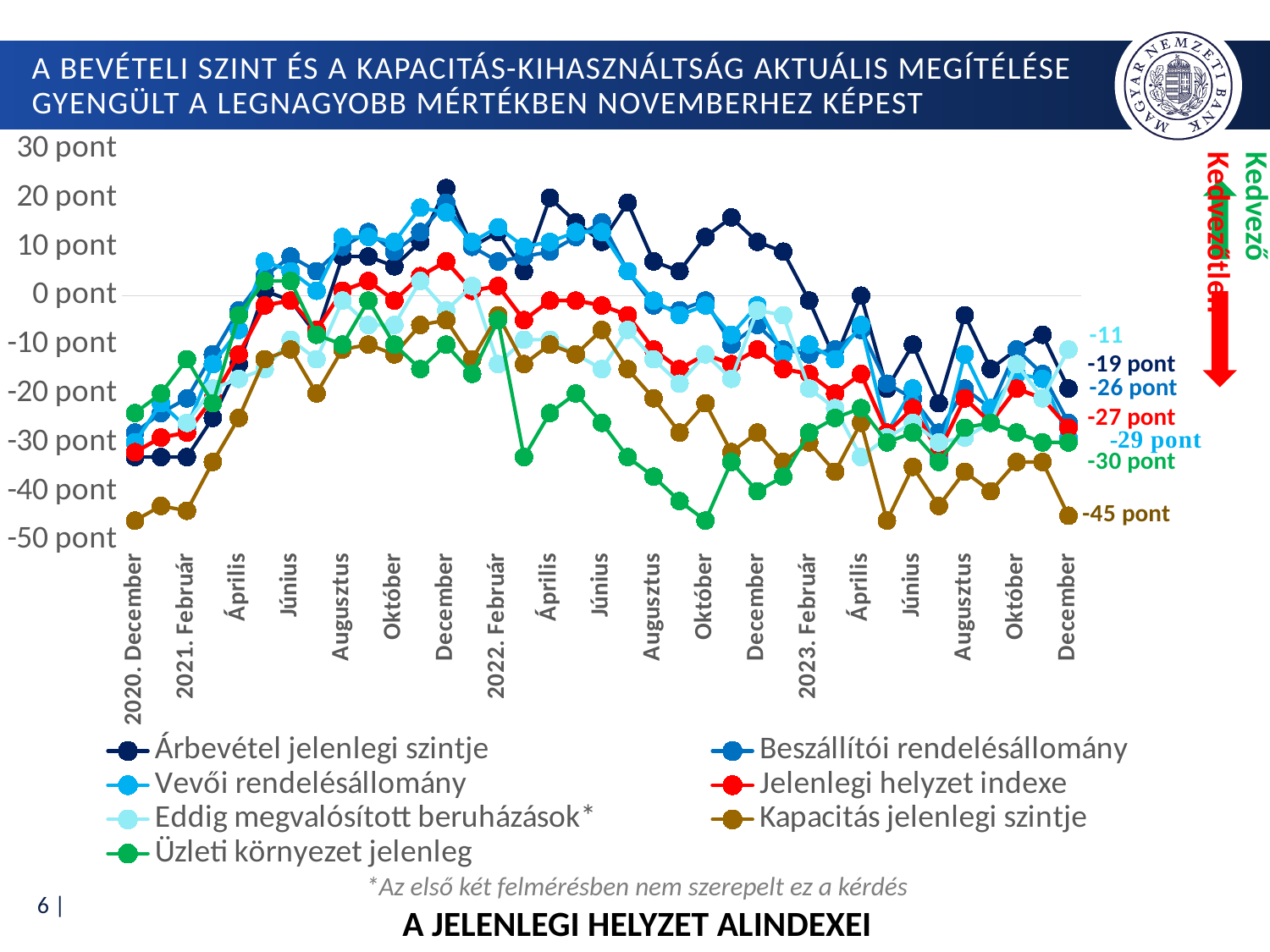
Which series has the lowest value at the last point (December 2023)? Kapacitás jelenlegi szintje What is the value of Üzleti környezet jelenleg at the last point (December 2023)? -30 pont How many series does the legend list? 7 Is the value of Kapacitás jelenlegi szintje at 2020. December greater or less than -40 pont? less At December 2023, which is higher: Beszállítói rendelésállomány or Vevői rendelésállomány? Beszállítói rendelésállomány Does Árbevétel jelenlegi szintje rise or fall between 2020. December and Június 2021? rise Which series has the highest value at the last point (December 2023)? Eddig megvalósított beruházások* What is the difference between the December 2023 values of Árbevétel jelenlegi szintje (-19 pont) and Kapacitás jelenlegi szintje (-45 pont)? 26 pont What is the value of Árbevétel jelenlegi szintje at the last point (December 2023)? -19 pont What type of chart is shown on the slide? line chart What is the value of Kapacitás jelenlegi szintje at the last point (December 2023)? -45 pont What is the value of Jelenlegi helyzet indexe at the last point (December 2023)? -27 pont